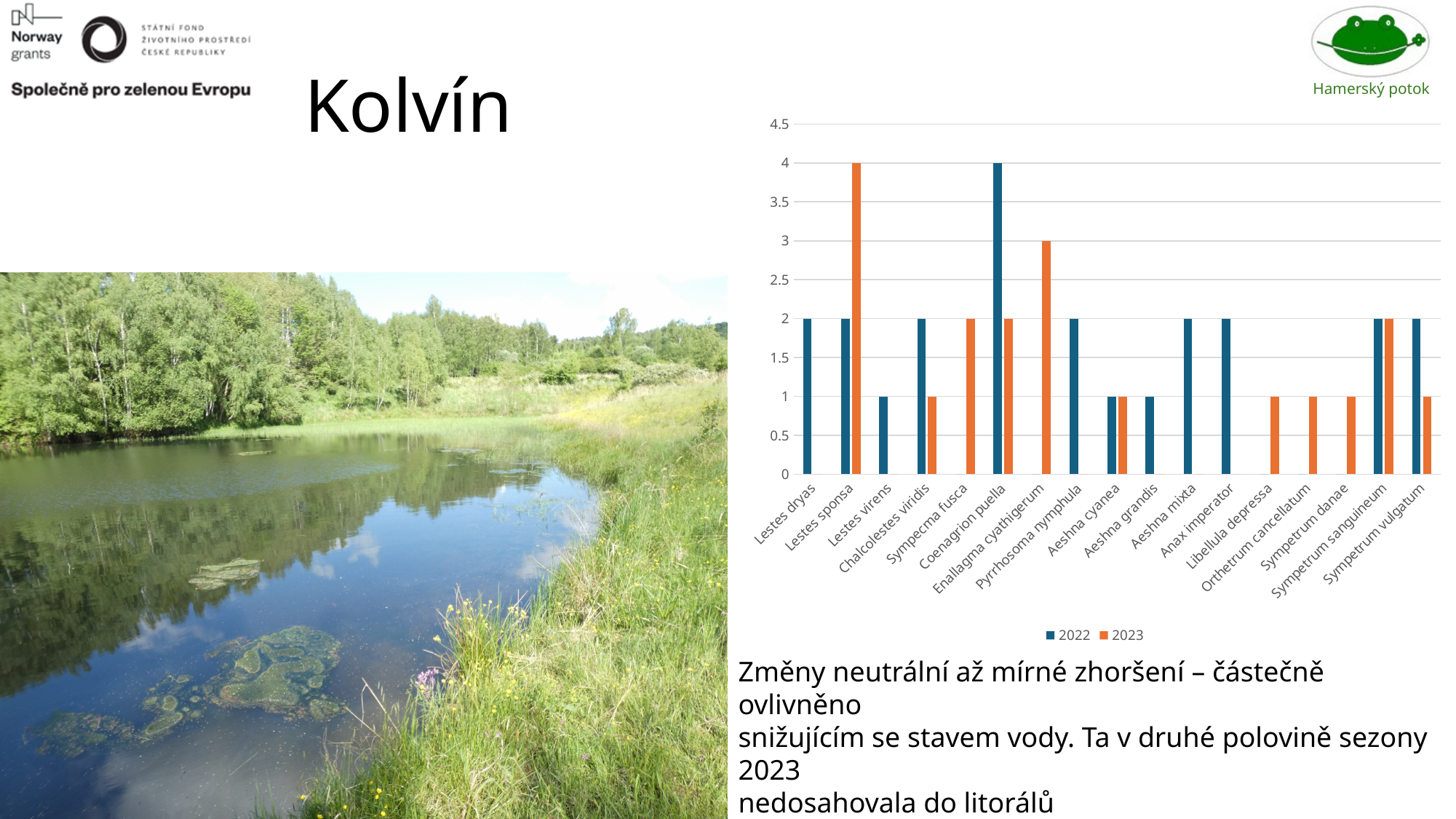
What is the difference between the 2022 and 2023 values for Coenagrion puella? 2 How many series does the chart legend list? 2 What is the 2023 value for Sympetrum vulgatum? 1 Which series is shown in orange in the chart legend? 2023 What is the 2023 value for Lestes sponsa? 4 What kind of chart is shown on the slide? Bar chart Which species has the highest 2022 value? Coenagrion puella Which species has the highest 2023 value? Lestes sponsa How many species categories are shown on the x axis of the chart? 17 What is the 2023 value for Enallagma cyathigerum? 3 What is the 2022 value for Coenagrion puella? 4 For Chalcolestes viridis, which year has the larger value, 2022 or 2023? 2022